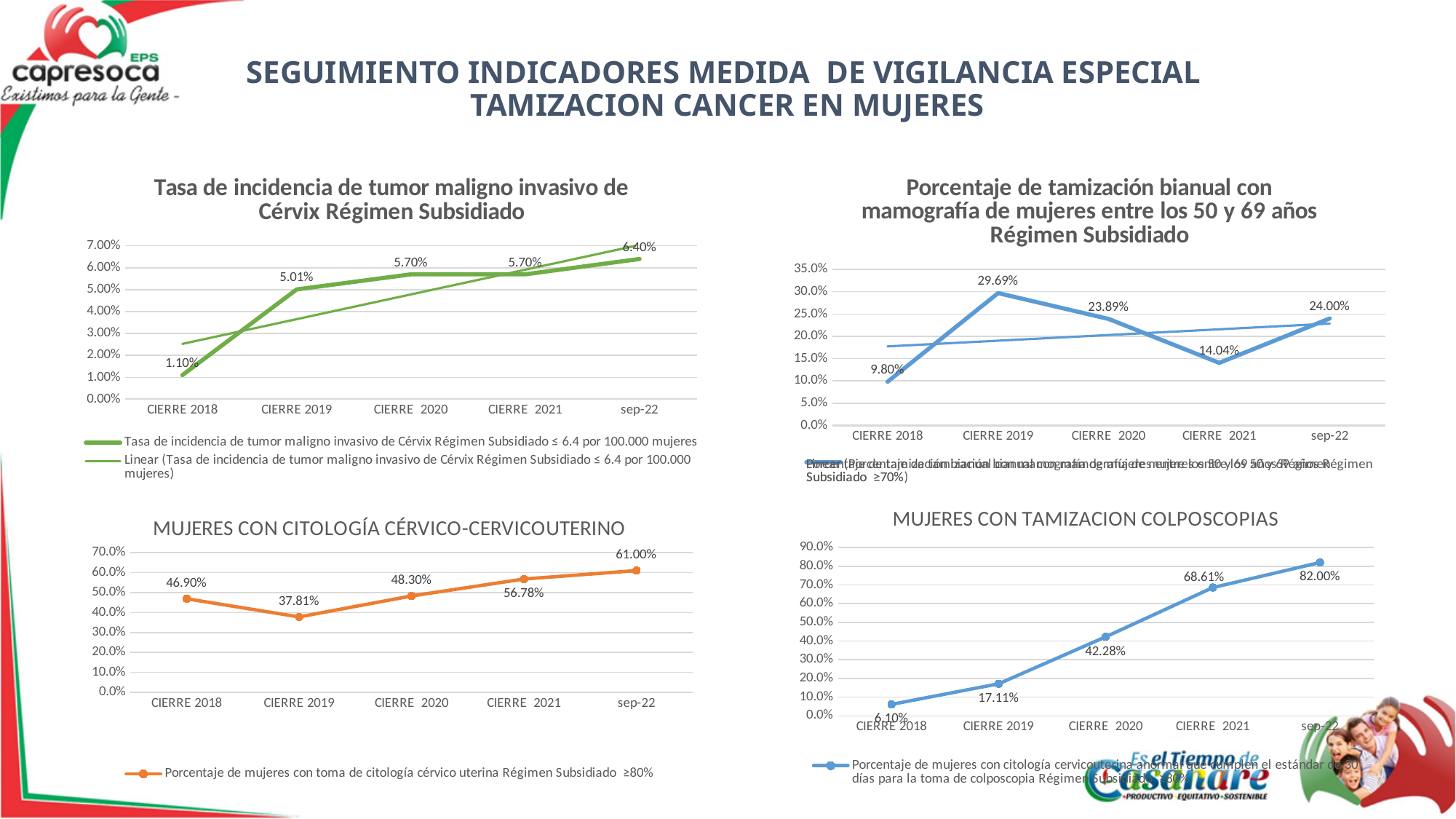
What kind of chart is 'MUJERES CON TAMIZACION COLPOSCOPIAS'? line chart In the chart 'MUJERES CON TAMIZACION COLPOSCOPIAS', what is the value for CIERRE 2020? 42.28% In the chart 'Porcentaje de tamización bianual con mamografía de mujeres entre los 50 y 69 años Régimen Subsidiado', which period has the highest value? CIERRE 2019 In the chart 'Tasa de incidencia de tumor maligno invasivo de Cérvix Régimen Subsidiado', what is the difference between the values for CIERRE 2019 and CIERRE 2018? 3.91% In the chart 'MUJERES CON TAMIZACION COLPOSCOPIAS', do the values rise or fall from CIERRE 2018 to sep-22? rise In the chart 'MUJERES CON CITOLOGÍA CÉRVICO-CERVICOUTERINO', what is the value for CIERRE 2021? 56.78% In the chart 'Porcentaje de tamización bianual con mamografía de mujeres entre los 50 y 69 años Régimen Subsidiado', what is the value for CIERRE 2021? 14.04% In the chart 'Tasa de incidencia de tumor maligno invasivo de Cérvix Régimen Subsidiado', what is the value for sep-22? 6.40% In the chart 'Porcentaje de tamización bianual con mamografía de mujeres entre los 50 y 69 años Régimen Subsidiado', which is larger: the value for CIERRE 2020 or the value for sep-22? sep-22 In the chart 'Tasa de incidencia de tumor maligno invasivo de Cérvix Régimen Subsidiado', what is the value for CIERRE 2018? 1.10% In the chart 'MUJERES CON CITOLOGÍA CÉRVICO-CERVICOUTERINO', which period has the lowest value? CIERRE 2019 In the chart 'MUJERES CON CITOLOGÍA CÉRVICO-CERVICOUTERINO', how many periods are plotted on the x axis? 5